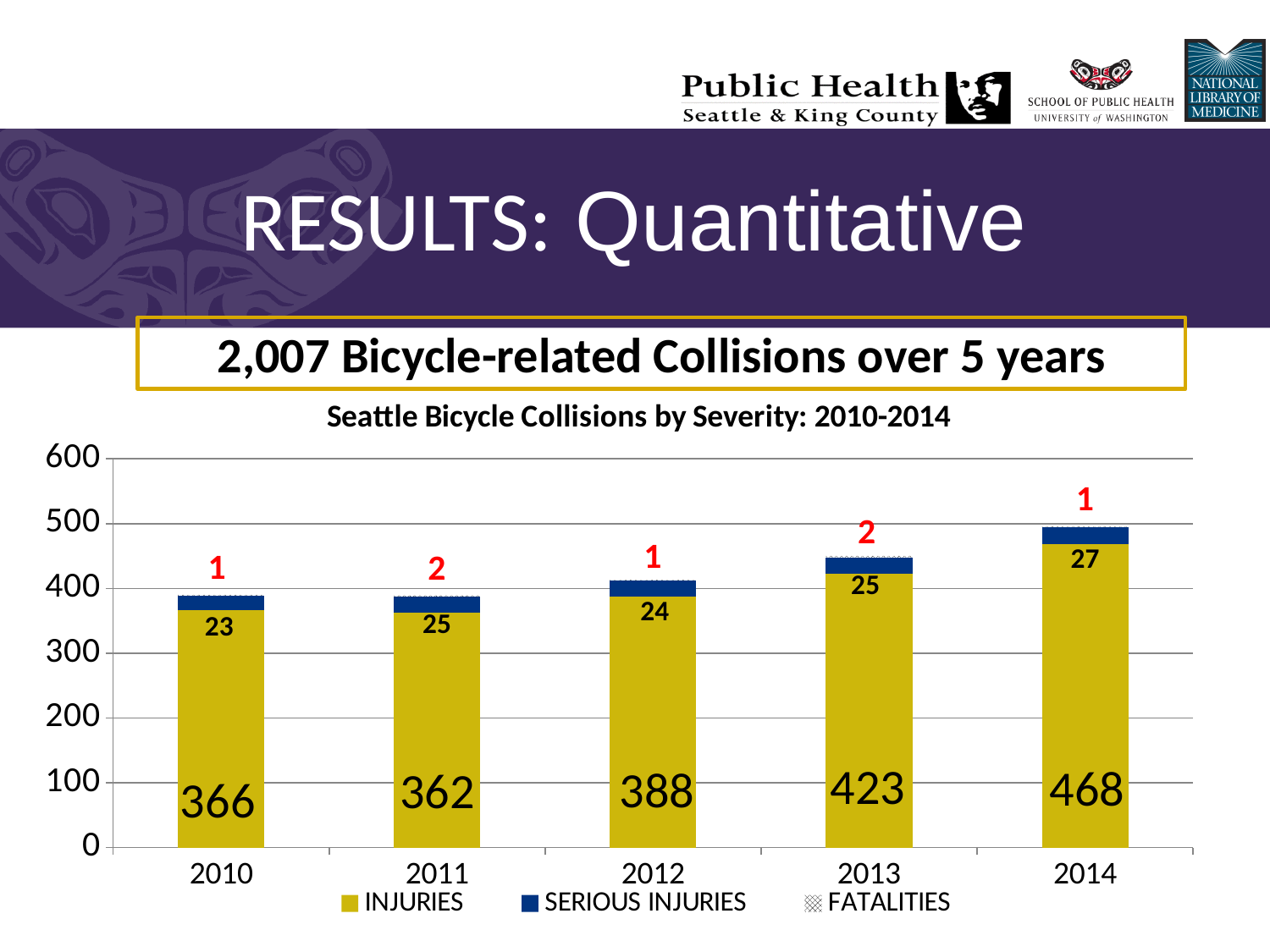
How many years are shown on the x axis? 5 What is the value for SERIOUS INJURIES in 2012? 24 How many series does the legend list? 3 What kind of chart is shown on the slide? Stacked bar chart What is the difference in INJURIES between 2014 and 2013? 45 What is the value for INJURIES in 2014? 468 Which year has the lowest number of INJURIES? 2011 What is the total height of the stacked bar for 2014 (INJURIES + SERIOUS INJURIES + FATALITIES)? 496 What is the title of the chart? Seattle Bicycle Collisions by Severity: 2010-2014 Which year has the highest number of INJURIES? 2014 Which year has more SERIOUS INJURIES, 2010 or 2014? 2014 What is the value for FATALITIES in 2013? 2